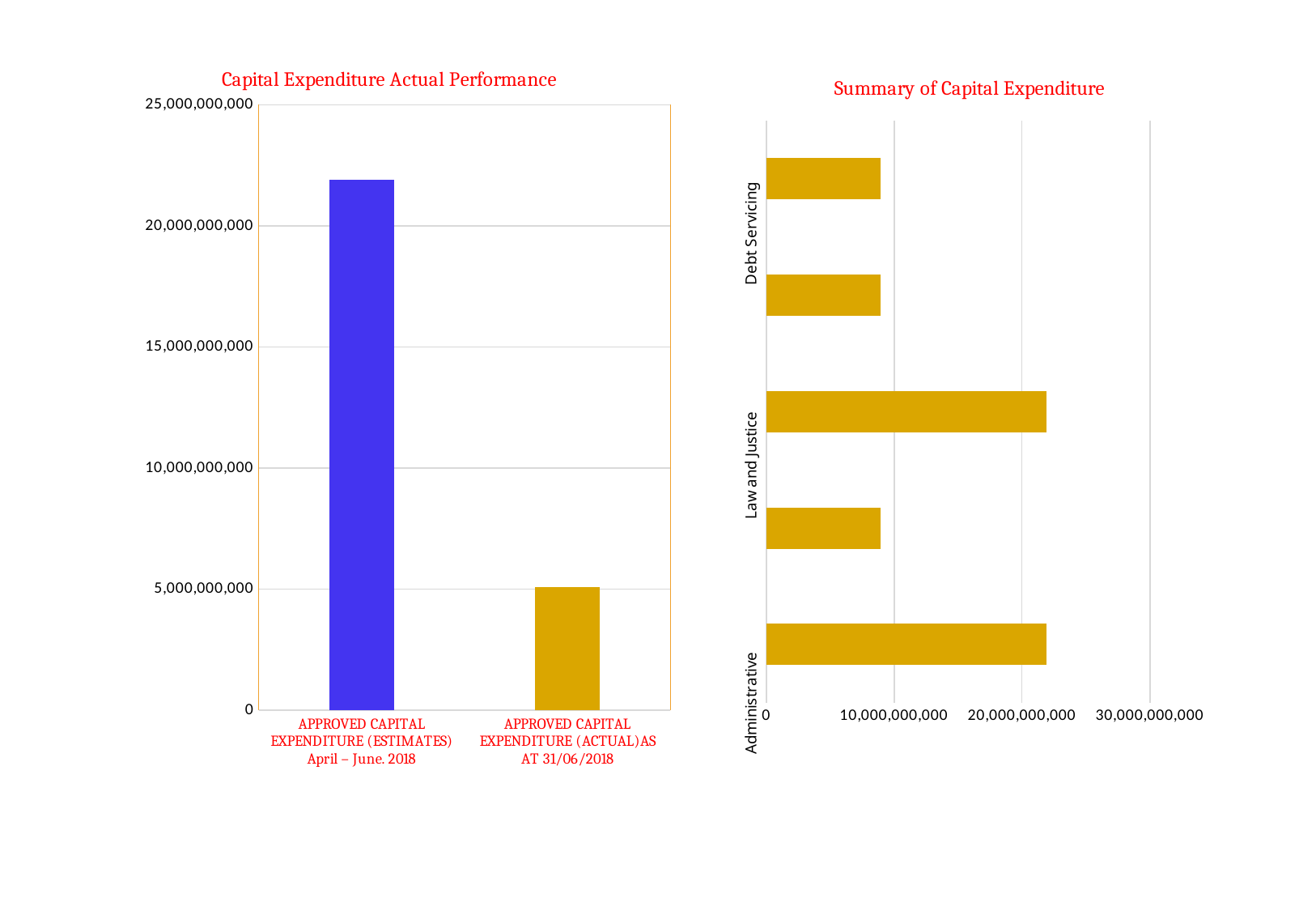
In the 'Capital Expenditure Actual Performance' chart, is the value for APPROVED CAPITAL EXPENDITURE (ESTIMATES) greater or less than 20,000,000,000? greater In the 'Capital Expenditure Actual Performance' chart, is the value for APPROVED CAPITAL EXPENDITURE (ACTUAL) AS AT 31/06/2018 greater or less than 10,000,000,000? less What is the title of the chart on the left of the slide? Capital Expenditure Actual Performance How many bars are plotted in the 'Summary of Capital Expenditure' chart? 5 In the 'Summary of Capital Expenditure' chart, is the value of the top bar greater or less than 10,000,000,000? less In the 'Capital Expenditure Actual Performance' chart, which category has the highest value? APPROVED CAPITAL EXPENDITURE (ESTIMATES) April – June. 2018 What kind of chart is the 'Capital Expenditure Actual Performance' chart? bar chart How many bars are plotted in the 'Capital Expenditure Actual Performance' chart? 2 What kind of chart is the 'Summary of Capital Expenditure' chart? bar chart In the 'Capital Expenditure Actual Performance' chart, which category has the lowest value? APPROVED CAPITAL EXPENDITURE (ACTUAL) AS AT 31/06/2018 In the 'Capital Expenditure Actual Performance' chart, which is larger: the approved capital expenditure estimates or the actual expenditure as at 31/06/2018? APPROVED CAPITAL EXPENDITURE (ESTIMATES)